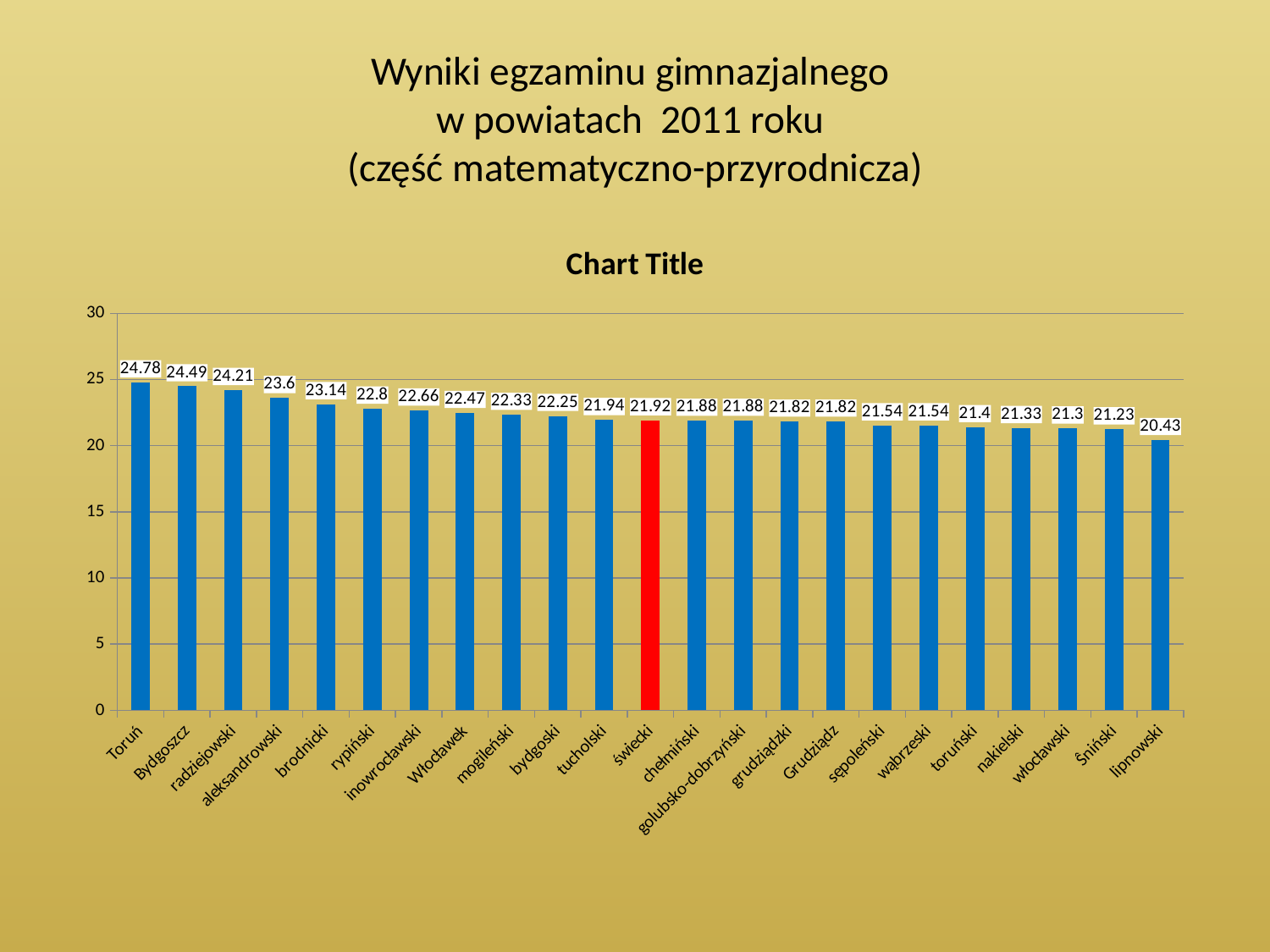
What is the value for brodnicki? 23.14 What is the difference between the values for Toruń and lipnowski? 4.35 What kind of chart is shown? bar chart Do the values rise or fall from left to right along the x axis? fall What is the value for lipnowski? 20.43 What is the value for świecki? 21.92 How many categories are shown on the x axis? 23 Which category's bar is coloured red? świecki What is the value for Toruń? 24.78 Which category has the lowest value? lipnowski Which category has the highest value? Toruń Which is larger, the value for Bydgoszcz or the value for Włocławek? Bydgoszcz